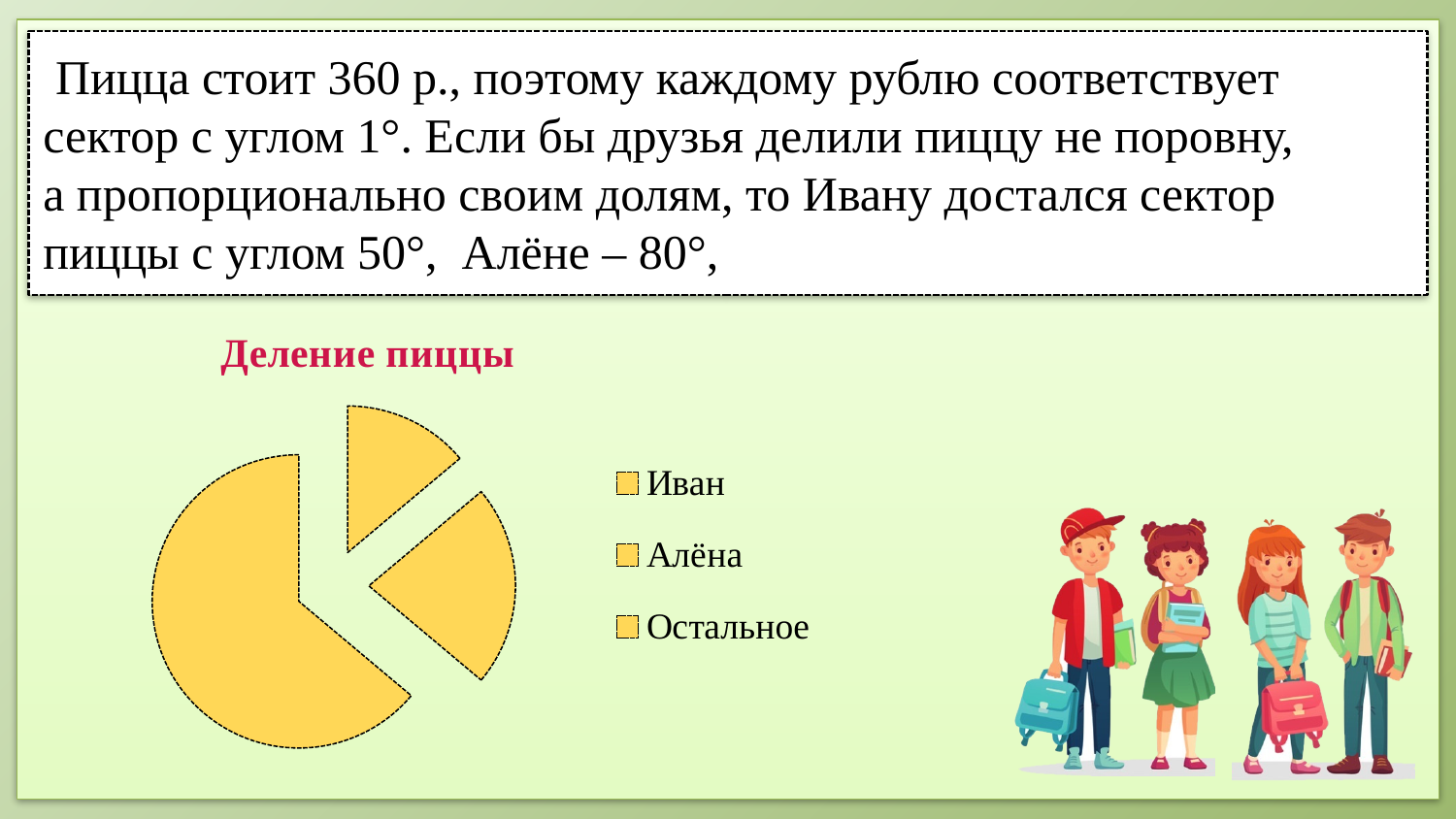
Is the slice for Остальное larger or smaller than half of the pie? larger What are the legend entries of the chart, in order? Иван, Алёна, Остальное What kind of chart is shown on the slide? pie chart How many slices does the pie chart have? 3 How many entries does the chart legend list? 3 What is the title of the chart? Деление пиццы Which category has the largest slice in the pie chart? Остальное